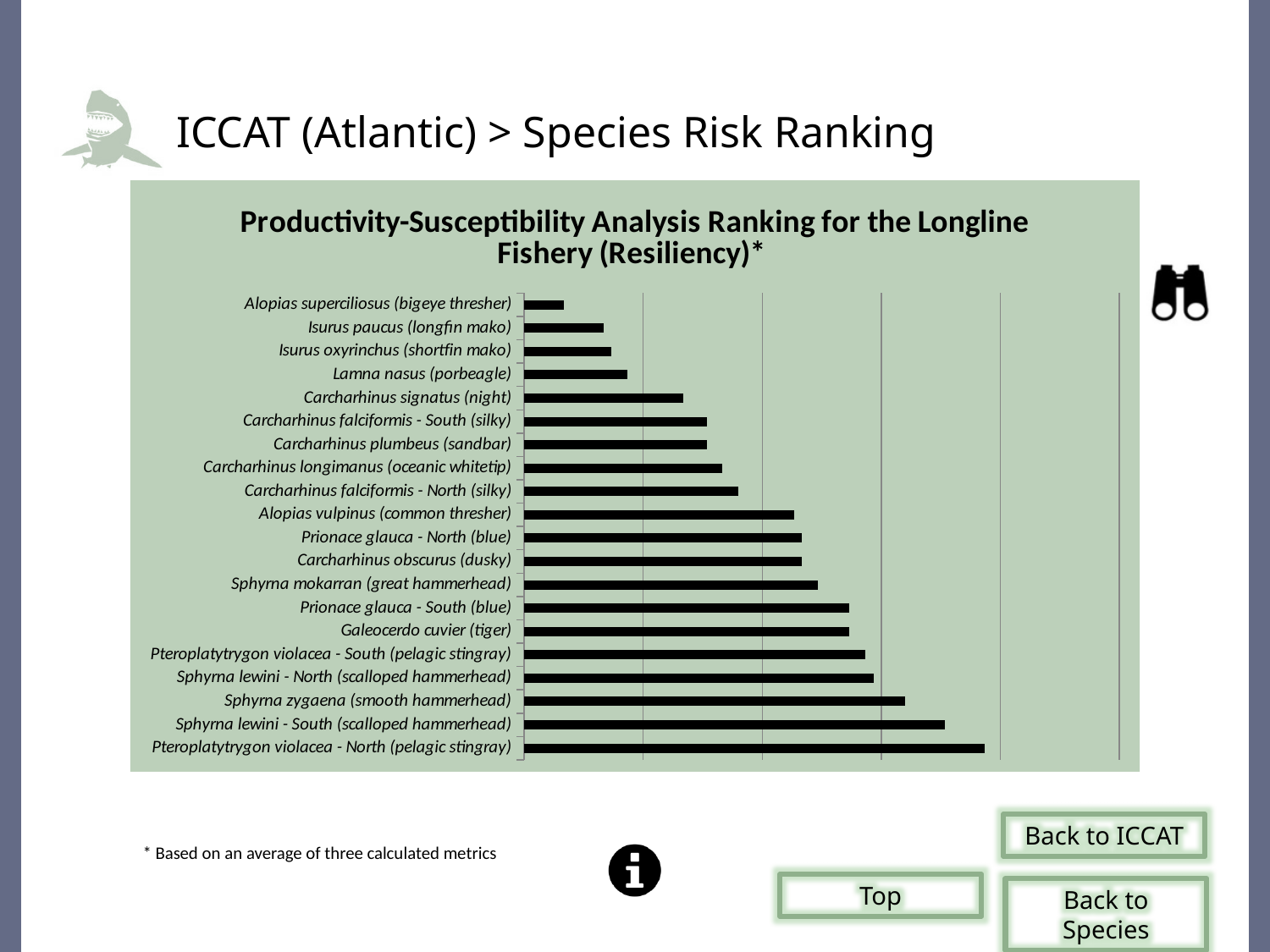
How many species are listed in the chart? 20 What kind of chart is shown on the slide? Bar chart Which species has the longest bar in the chart? Pteroplatytrygon violacea - North (pelagic stingray) Which has the longer bar, Lamna nasus (porbeagle) or Carcharhinus signatus (night)? Carcharhinus signatus (night) Which has the longer bar, Sphyrna zygaena (smooth hammerhead) or Sphyrna lewini - South (scalloped hammerhead)? Sphyrna lewini - South (scalloped hammerhead) Which has the longer bar, Alopias superciliosus (bigeye thresher) or Galeocerdo cuvier (tiger)? Galeocerdo cuvier (tiger) What is the title of the chart? Productivity-Susceptibility Analysis Ranking for the Longline Fishery (Resiliency)* According to the footnote, what is the chart's ranking based on? An average of three calculated metrics Which species has the shortest bar in the chart? Alopias superciliosus (bigeye thresher) Do the bar lengths increase or decrease going from the top of the chart to the bottom? Increase